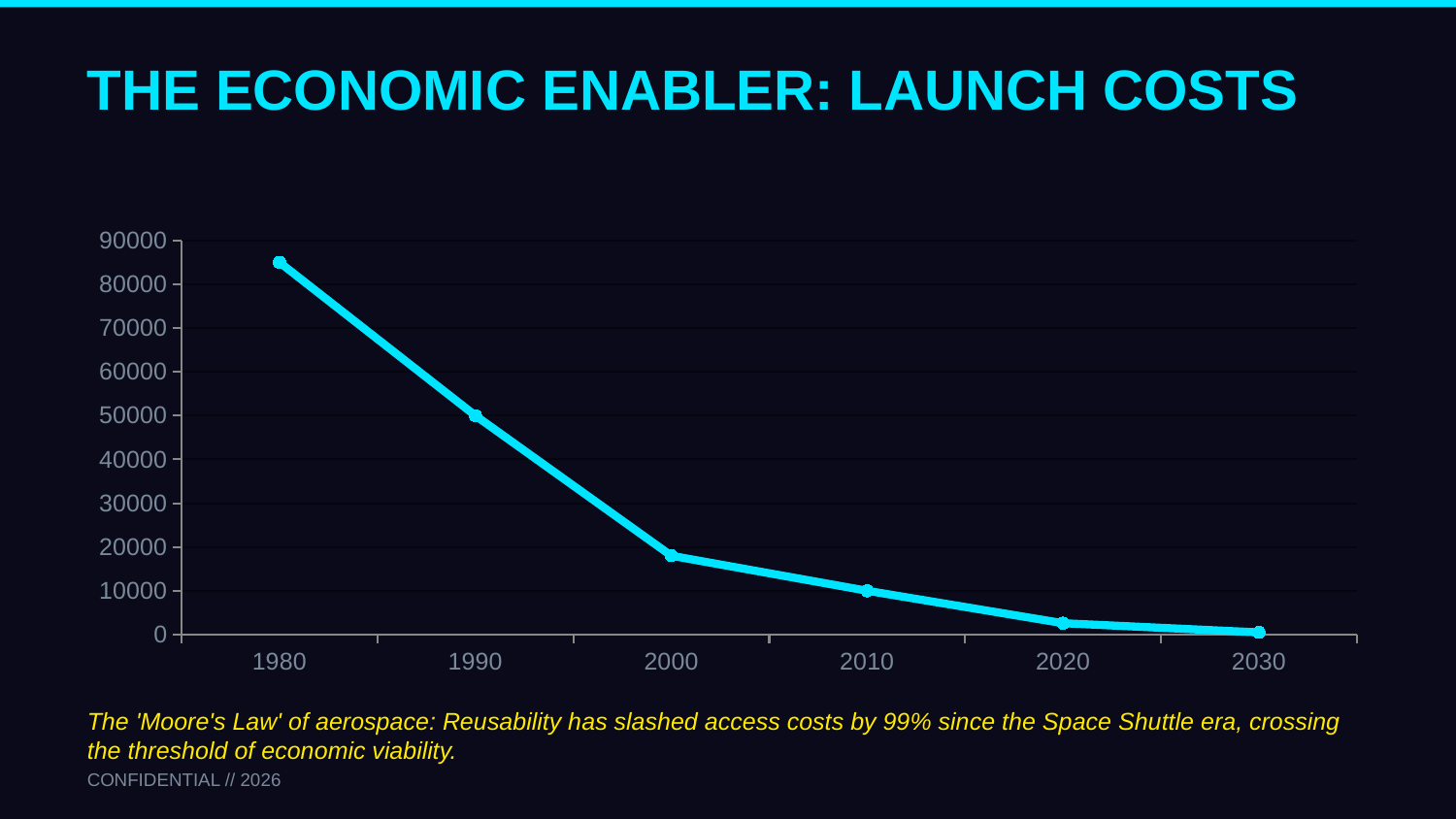
Which year has the highest value? 1980 Is the value for 2000 greater or less than 20000? less Is the value for 1980 greater or less than 80000? greater Which year has the lowest value? 2030 Is the value for 2020 greater or less than 10000? less How many data points are plotted on the line? 6 What is the title of the slide containing the chart? THE ECONOMIC ENABLER: LAUNCH COSTS What kind of chart is shown on the slide? line chart What is the value for 1990? 50000 Do the values rise or fall from 1980 to 2030? fall Which is larger, the value for 1990 or the value for 2000? 1990